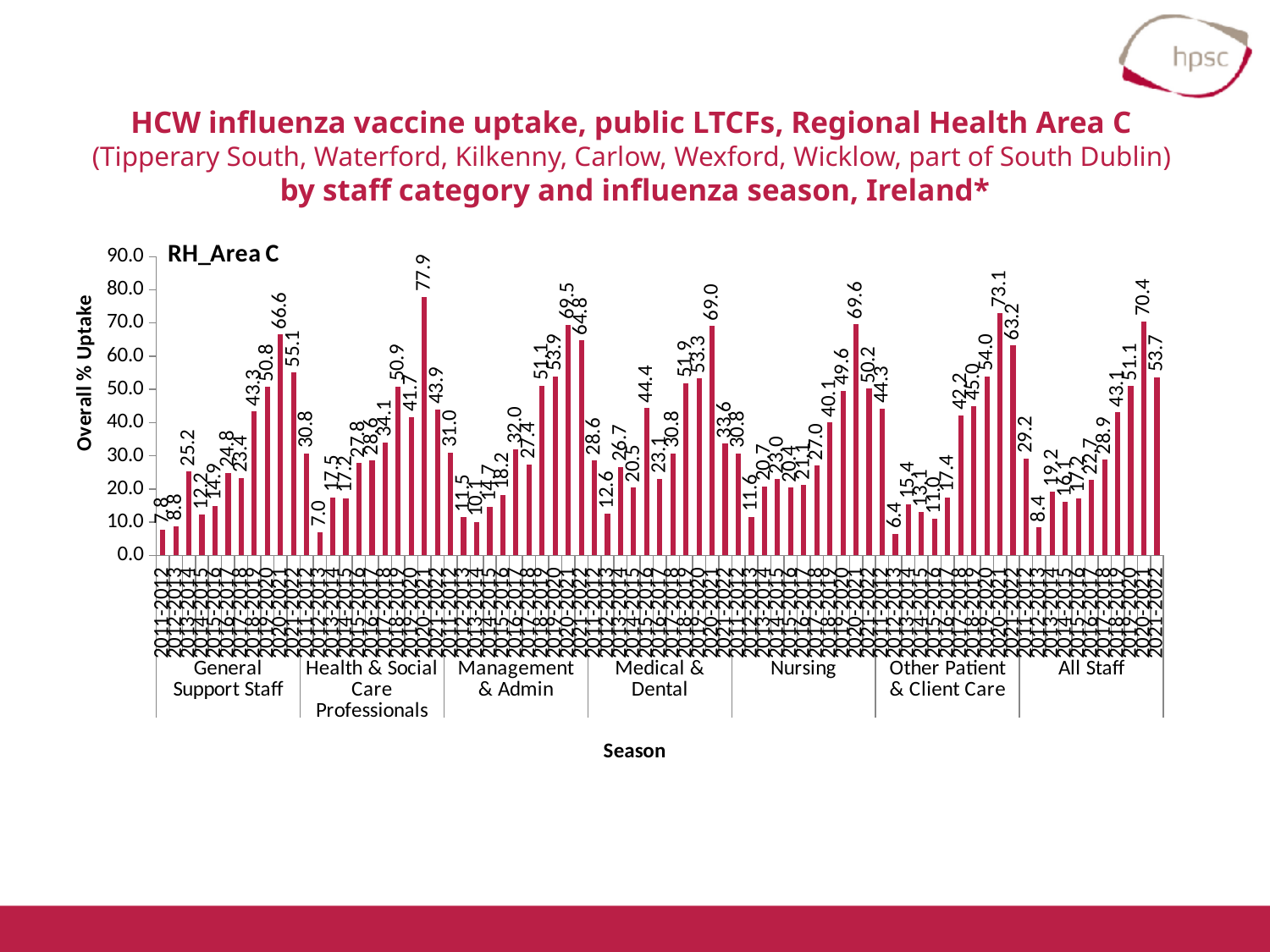
What is the label on the vertical axis of the chart? Overall % Uptake What is the highest value shown anywhere on the chart? 77.9 What is the lowest value shown anywhere on the chart? 6.4 What type of chart is shown on the slide? bar chart What is the difference between the highest value (77.9) and the lowest value (6.4) on the chart? 71.5 What is the highest value in the Other Patient & Client Care group? 73.1 What is the title printed inside the chart area? RH_Area C Which is larger: the highest bar in the Health & Social Care Professionals group or the highest bar in the Other Patient & Client Care group? Health & Social Care Professionals Which staff category group contains the highest bar on the chart? Health & Social Care Professionals Which staff category group contains the lowest bar on the chart? Other Patient & Client Care How many staff category groups are shown along the x axis? 7